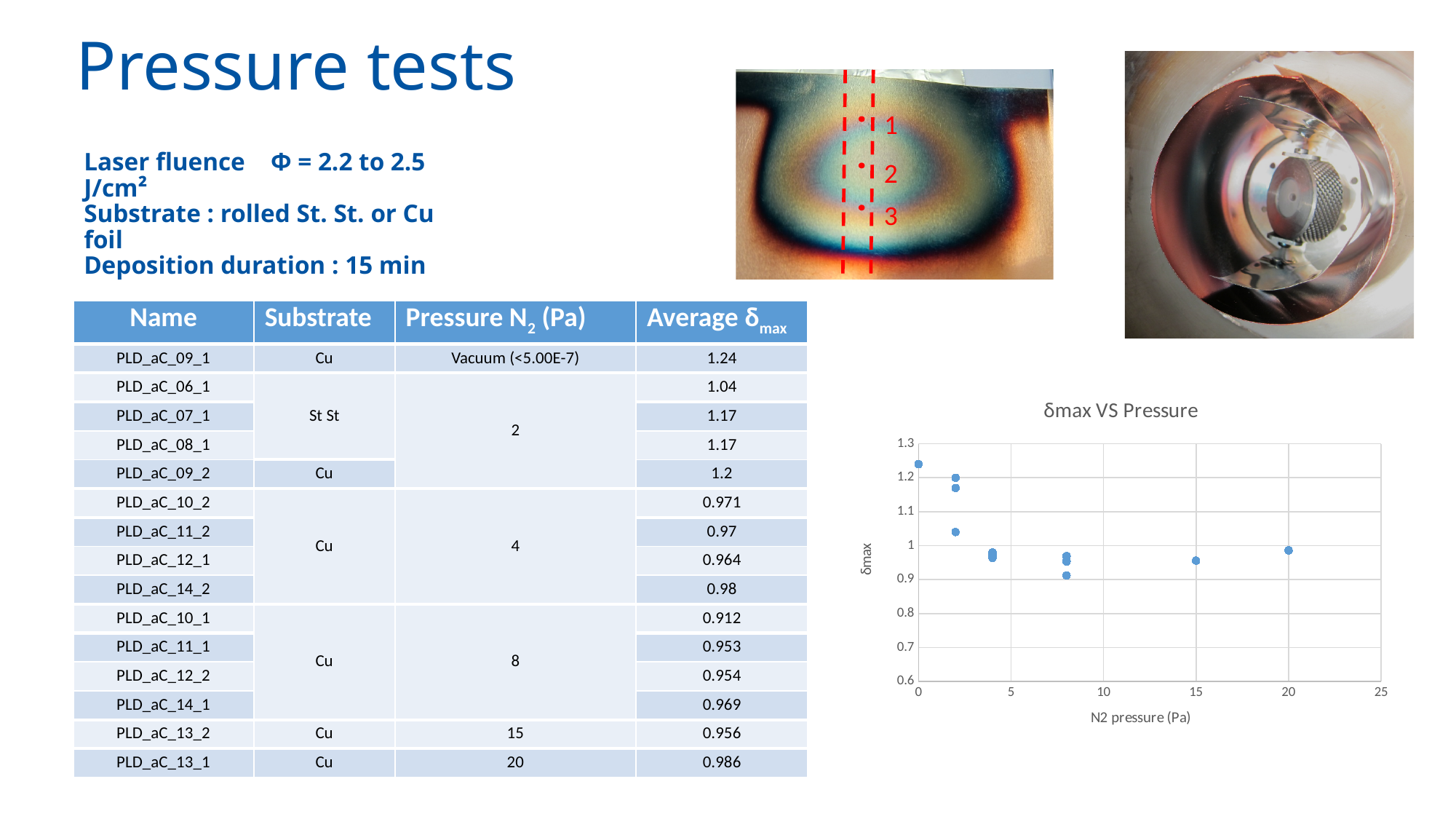
How many distinct N2 pressure values have points plotted in the "δmax VS Pressure" chart? 6 In the "δmax VS Pressure" chart, is the δmax value at 20 Pa greater or less than 0.9? greater In the "δmax VS Pressure" chart, is the δmax value at 0 Pa greater or less than 1.1? greater In the "δmax VS Pressure" chart, at which N2 pressure is the lowest δmax value plotted? 8 Pa In the "δmax VS Pressure" chart, at which N2 pressure is the highest δmax value plotted? 0 Pa What kind of chart is the "δmax VS Pressure" chart? scatter chart What is the title of the chart on the right of the slide? δmax VS Pressure In the "δmax VS Pressure" chart, is the δmax value at 15 Pa greater or less than 1? less In the "δmax VS Pressure" chart, which has the higher δmax: the point at 0 Pa or the point at 15 Pa? 0 Pa In the "δmax VS Pressure" chart, does δmax generally rise or fall as N2 pressure increases from 0 to 8 Pa? fall What is the x-axis label of the "δmax VS Pressure" chart? N2 pressure (Pa)